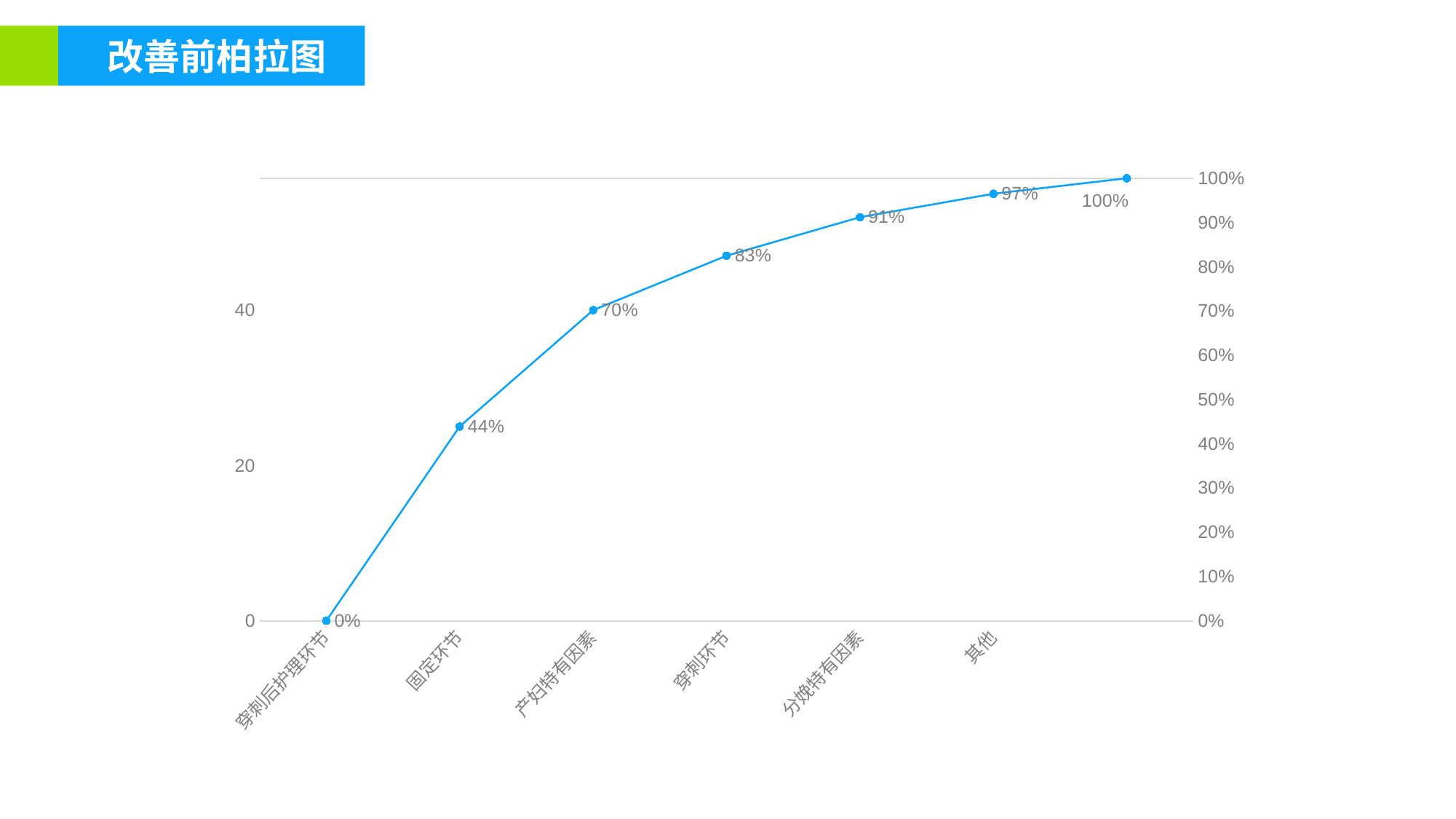
What is the value labelled on the fourth point of the line? 83% Do the values of the line rise or fall from left to right? rise What is the highest tick shown on the left vertical axis? 40 How many data points are plotted on the line? 7 What is the title of the slide containing the chart? 改善前柏拉图 What is the difference between the third point (70%) and the second point (44%) on the line? 26% What is the value labelled on the second point of the line? 44% What is the lowest value labelled on the line? 0% What kind of chart is shown on the slide? line chart What is the highest value labelled on the line? 100% How many category labels are shown along the x axis? 6 Which is larger, the value at the fifth point (91%) or the value at the sixth point (97%)? 97%